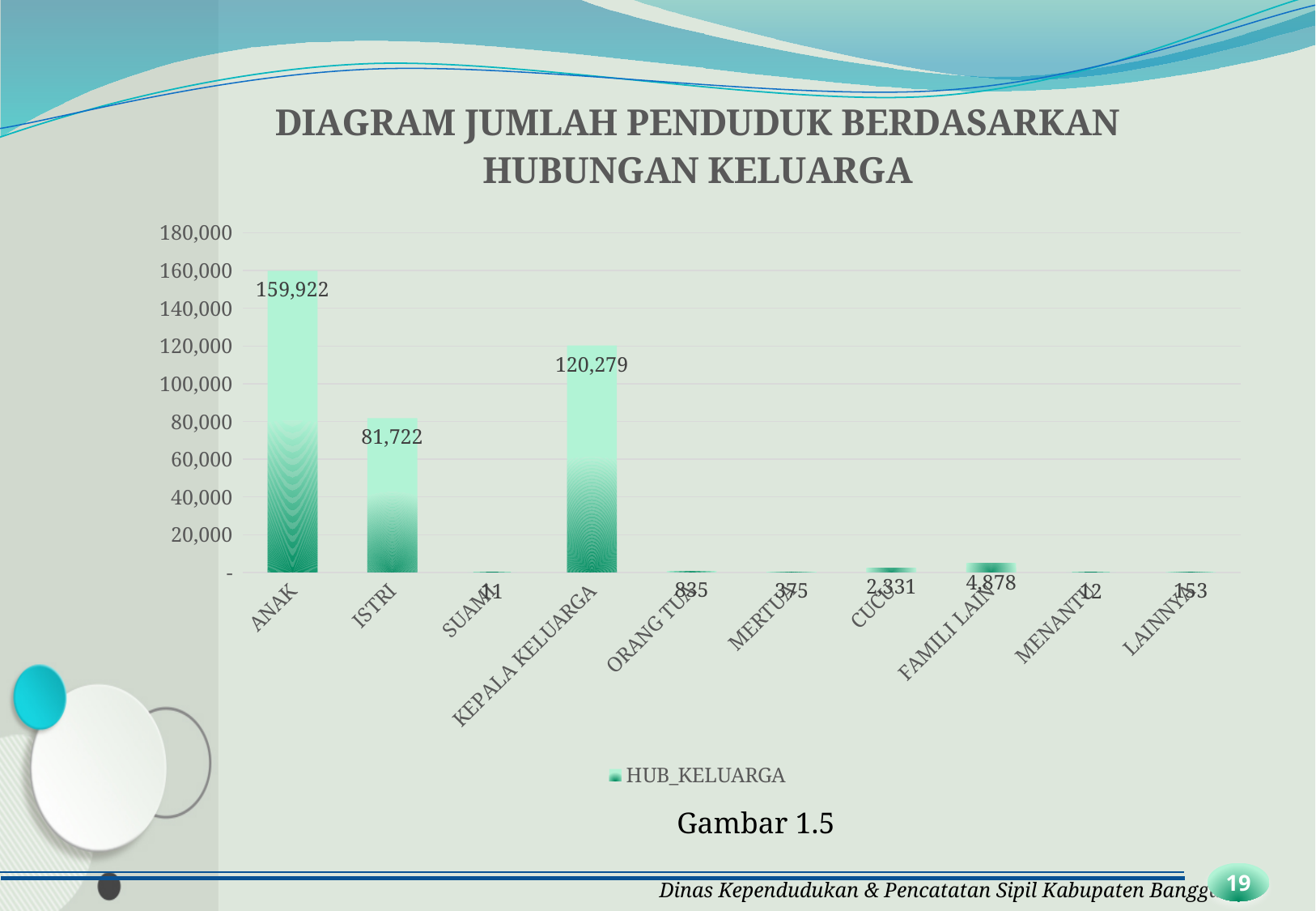
Which category has the highest value? ANAK What is the value for FAMILI LAIN? 4,878 What kind of chart is shown on the slide? bar chart How many categories are shown on the x axis? 10 What series name does the legend show? HUB_KELUARGA What is the value for KEPALA KELUARGA? 120,279 What is the value for ISTRI? 81,722 Is the value for ISTRI greater or less than 100,000? less What is the value for ANAK? 159,922 Which is larger, the value for ISTRI or the value for KEPALA KELUARGA? KEPALA KELUARGA What is the value for CUCU? 2,331 What is the difference between the values for ANAK and KEPALA KELUARGA? 39,643